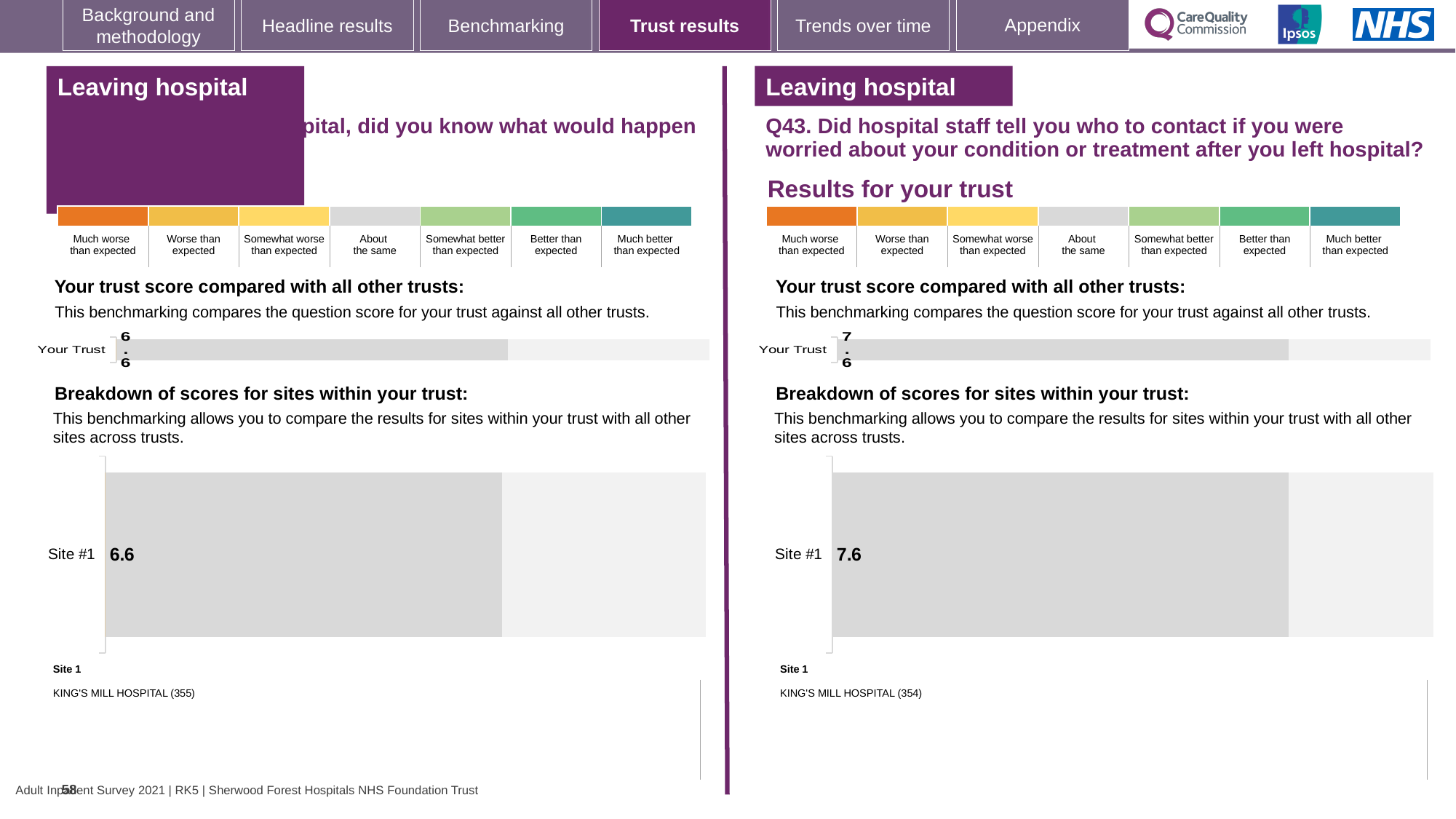
How many sites are shown in the right-hand 'Breakdown of scores for sites within your trust' chart (Q43)? 1 In the left-hand 'Breakdown of scores for sites within your trust' chart, what is the value for Site #1? 6.6 How many sites are shown in the left-hand 'Breakdown of scores for sites within your trust' chart? 1 What is the difference between the Site #1 score in the right-hand breakdown chart (Q43) and the Site #1 score in the left-hand breakdown chart? 1.0 Is the Your Trust score in the right-hand chart (Q43) the same as the Site #1 score in the right-hand breakdown chart? Yes, both are 7.6 In the right-hand 'Breakdown of scores for sites within your trust' chart (Q43), what is the value for Site #1? 7.6 What type of chart is used for the 'Breakdown of scores for sites within your trust' on the right-hand side (Q43)? Bar chart On the right-hand side (Q43), what is the score shown for Your Trust in the 'Your trust score compared with all other trusts' chart? 7.6 On the left-hand side of the slide, what is the score shown for Your Trust in the 'Your trust score compared with all other trusts' chart? 6.6 Which is larger: the Site #1 score in the left-hand breakdown chart or the Site #1 score in the right-hand breakdown chart (Q43)? The right-hand (Q43) Site #1 score Which hospital is listed as Site 1 beneath the right-hand breakdown chart (Q43)? KING'S MILL HOSPITAL (354) Which hospital is listed as Site 1 beneath the left-hand breakdown chart? KING'S MILL HOSPITAL (355)